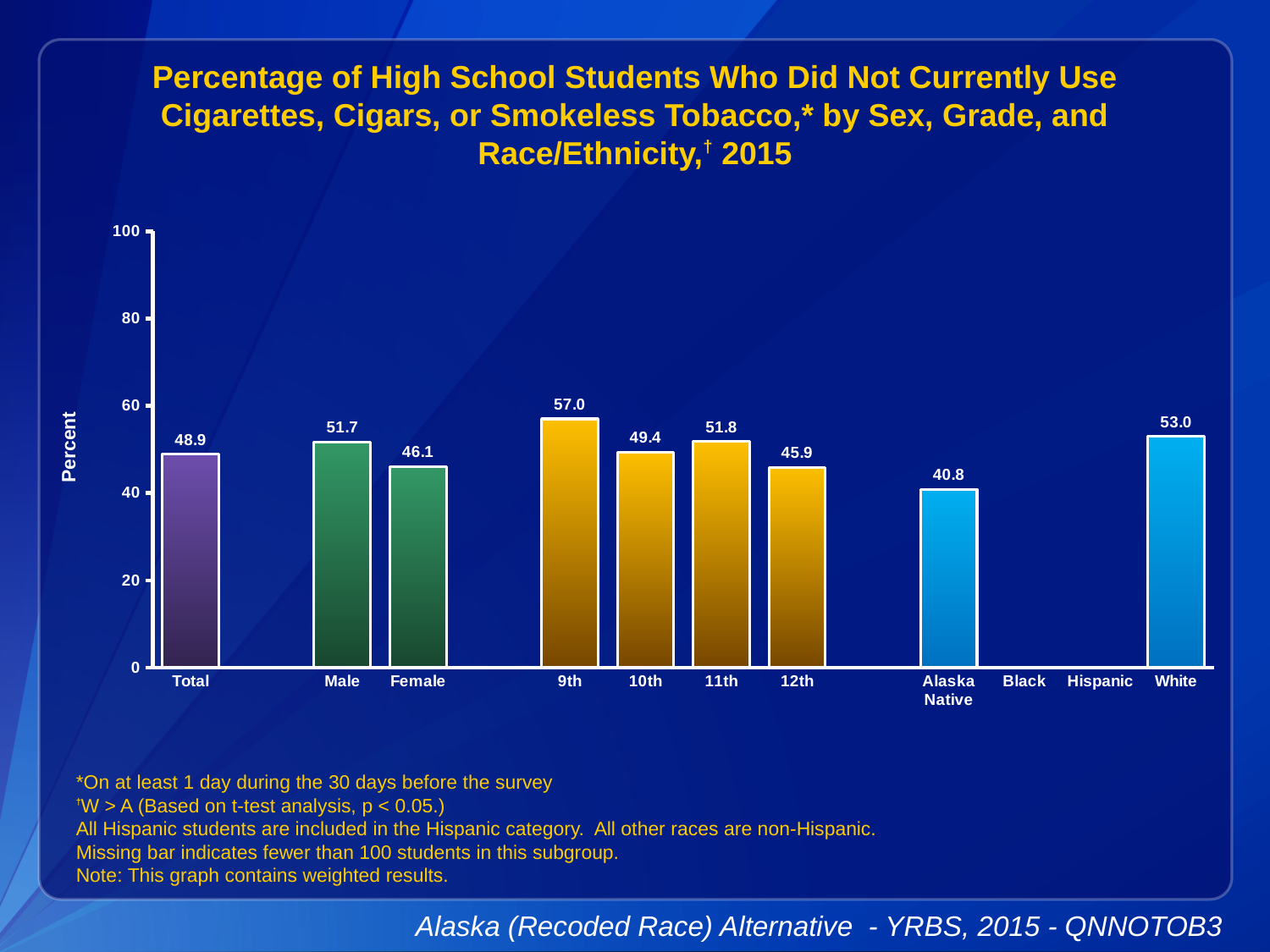
How many bars are plotted on the chart? 9 What is the difference between the values for Male and Female? 5.6 Which category has the lowest value among the bars shown? Alaska Native Which category has the highest value? 9th What is the value for White? 53.0 What is the value for Female? 46.1 What is the value for Alaska Native? 40.8 Which is larger, the value for 10th or the value for 12th? 10th What is the label of the y axis? Percent What is the value for Total? 48.9 Is the value for 9th greater or less than 40? greater What kind of chart is shown? bar chart